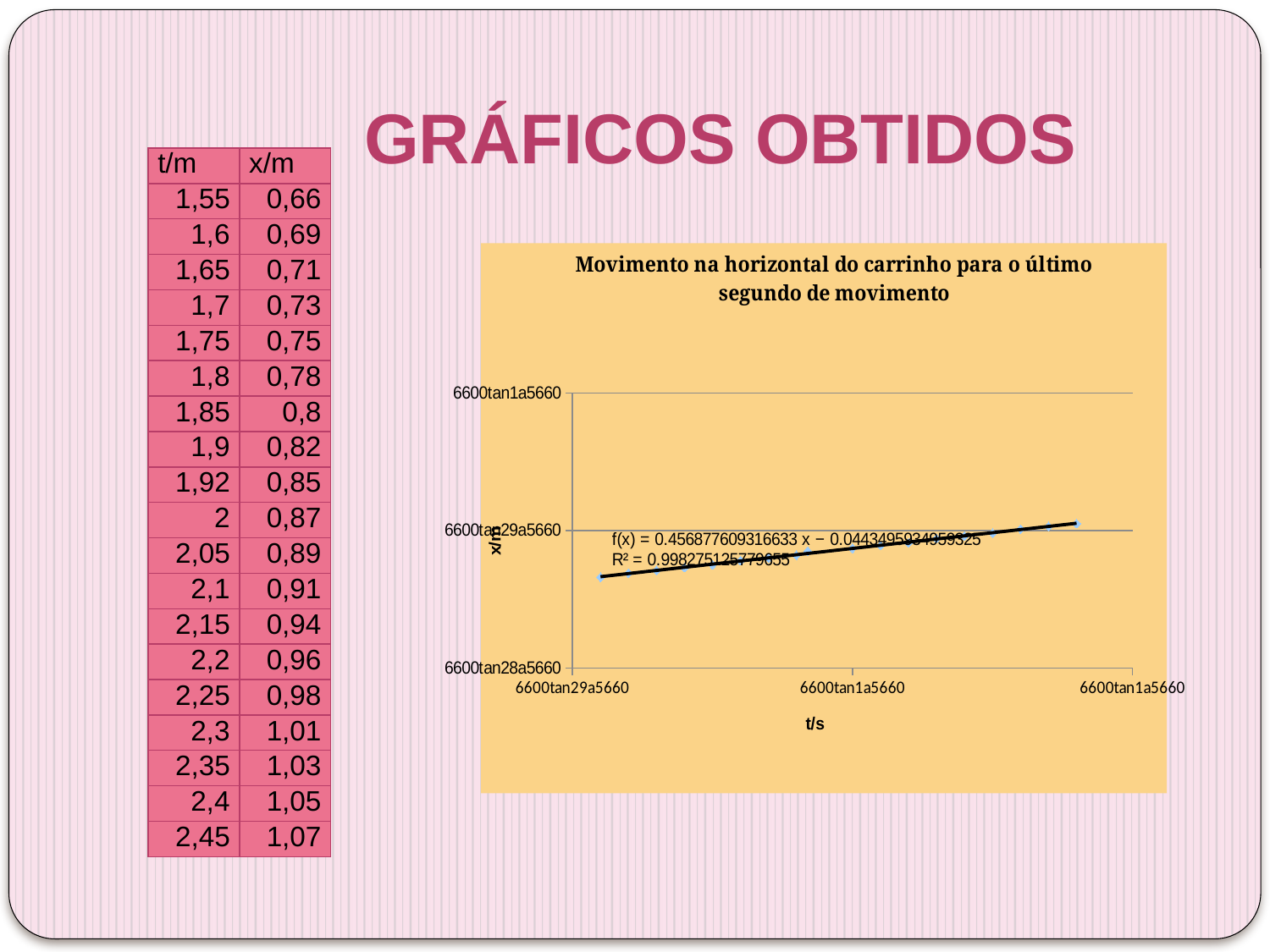
Do the plotted values rise or fall as t increases along the x axis? rise What kind of chart is shown on the slide? scatter chart What is the label of the horizontal axis of the chart? t/s What is the slope of the trendline equation shown on the chart? 0.456877609316633 What is the title of the chart? Movimento na horizontal do carrinho para o último segundo de movimento